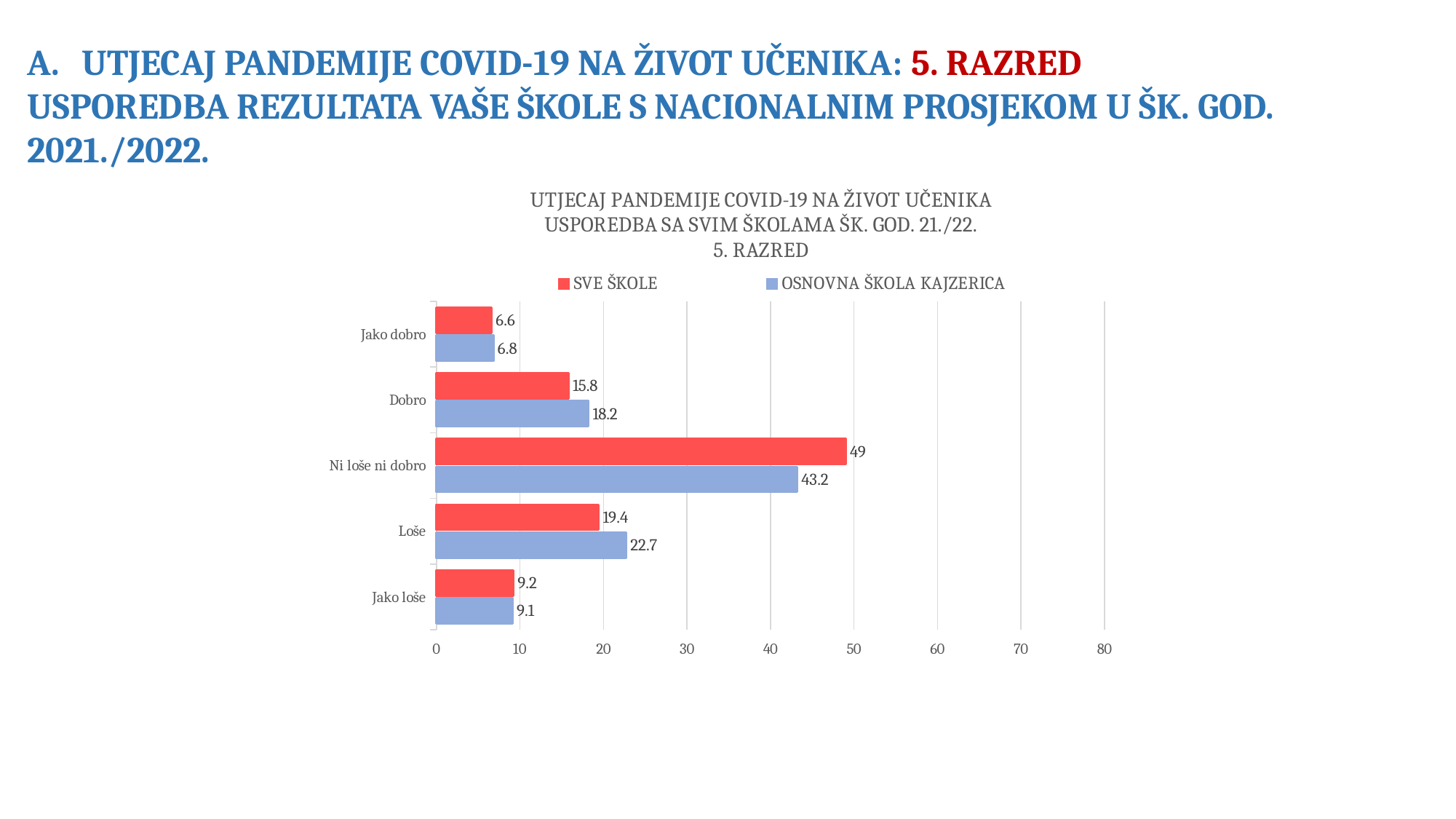
What is the value for OSNOVNA ŠKOLA KAJZERICA in the Loše category? 22.7 How many series does the legend list? 2 Which category has the highest value for SVE ŠKOLE? Ni loše ni dobro What is the value for SVE ŠKOLE in the Ni loše ni dobro category? 49 What is the value for OSNOVNA ŠKOLA KAJZERICA in the Dobro category? 18.2 In the Loše category, which series has the larger value, SVE ŠKOLE or OSNOVNA ŠKOLA KAJZERICA? OSNOVNA ŠKOLA KAJZERICA Is the value for OSNOVNA ŠKOLA KAJZERICA in the Ni loše ni dobro category greater or less than 40? greater Which colour represents the SVE ŠKOLE series? red Which category has the lowest value for OSNOVNA ŠKOLA KAJZERICA? Jako dobro What is the difference between SVE ŠKOLE and OSNOVNA ŠKOLA KAJZERICA in the Ni loše ni dobro category? 5.8 What kind of chart is shown on the slide? bar chart How many categories are shown on the chart? 5